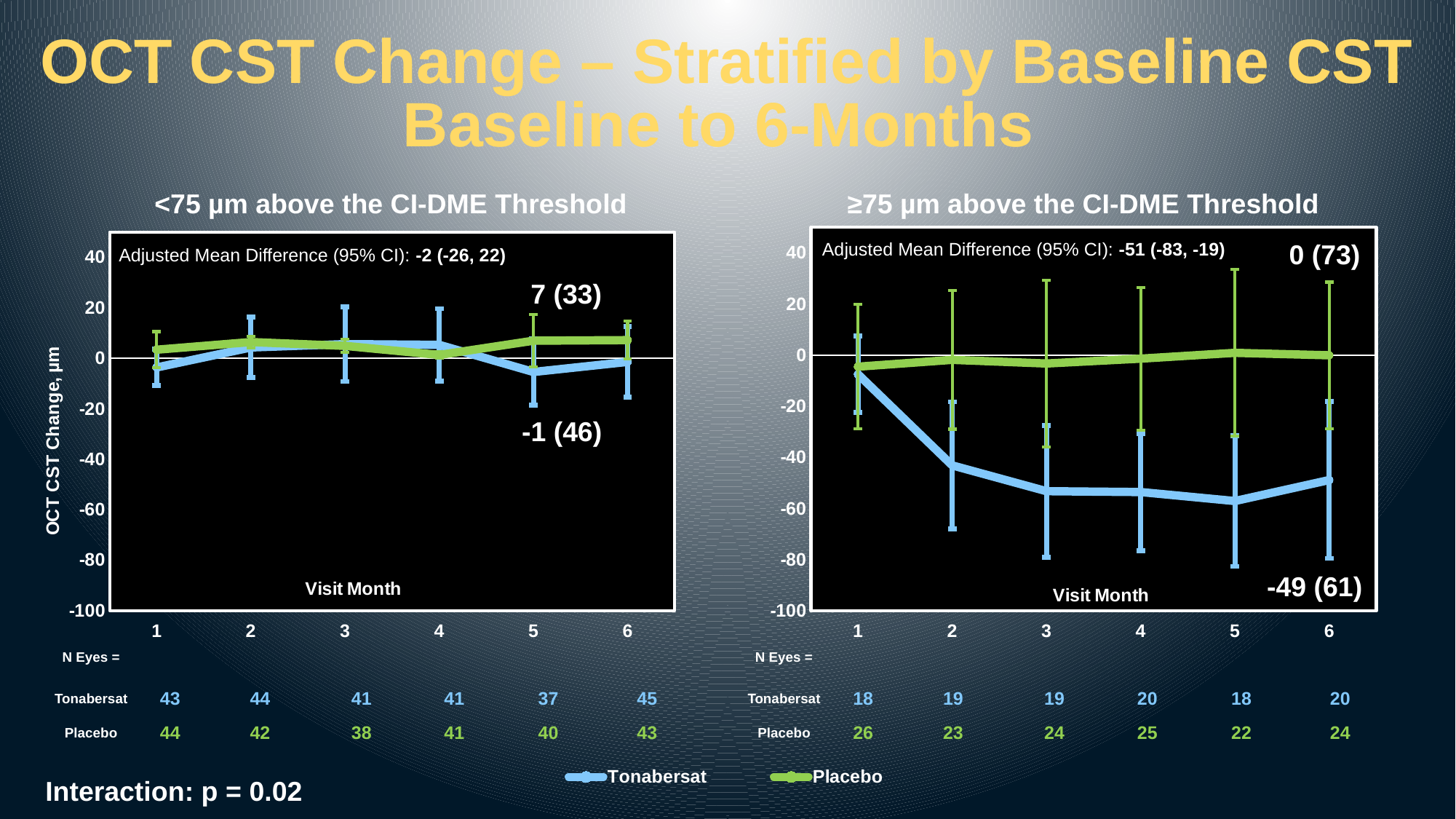
In the '≥75 µm above the CI-DME Threshold' chart, what is the Adjusted Mean Difference (95% CI)? -51 (-83, -19) In the '<75 µm above the CI-DME Threshold' chart, what is the labelled value for Tonabersat at month 6? -1 (46) What kind of chart is shown on the slide? Line chart In the '≥75 µm above the CI-DME Threshold' chart, does the Tonabersat line rise or fall from month 1 to month 3? Fall In the '<75 µm above the CI-DME Threshold' chart, what is the labelled value for Placebo at month 6? 7 (33) In the '≥75 µm above the CI-DME Threshold' chart, is the Tonabersat value at month 3 greater or less than -40? less How many series does the legend list? 2 In the '≥75 µm above the CI-DME Threshold' chart, which series has the higher value at month 6, Tonabersat or Placebo? Placebo In the '≥75 µm above the CI-DME Threshold' chart, what is the labelled value for Tonabersat at month 6? -49 (61) In the '<75 µm above the CI-DME Threshold' chart, how many visit months are plotted on the x axis? 6 In the '≥75 µm above the CI-DME Threshold' chart, what is the labelled value for Placebo at month 6? 0 (73) In the '<75 µm above the CI-DME Threshold' chart, what is the Adjusted Mean Difference (95% CI)? -2 (-26, 22)